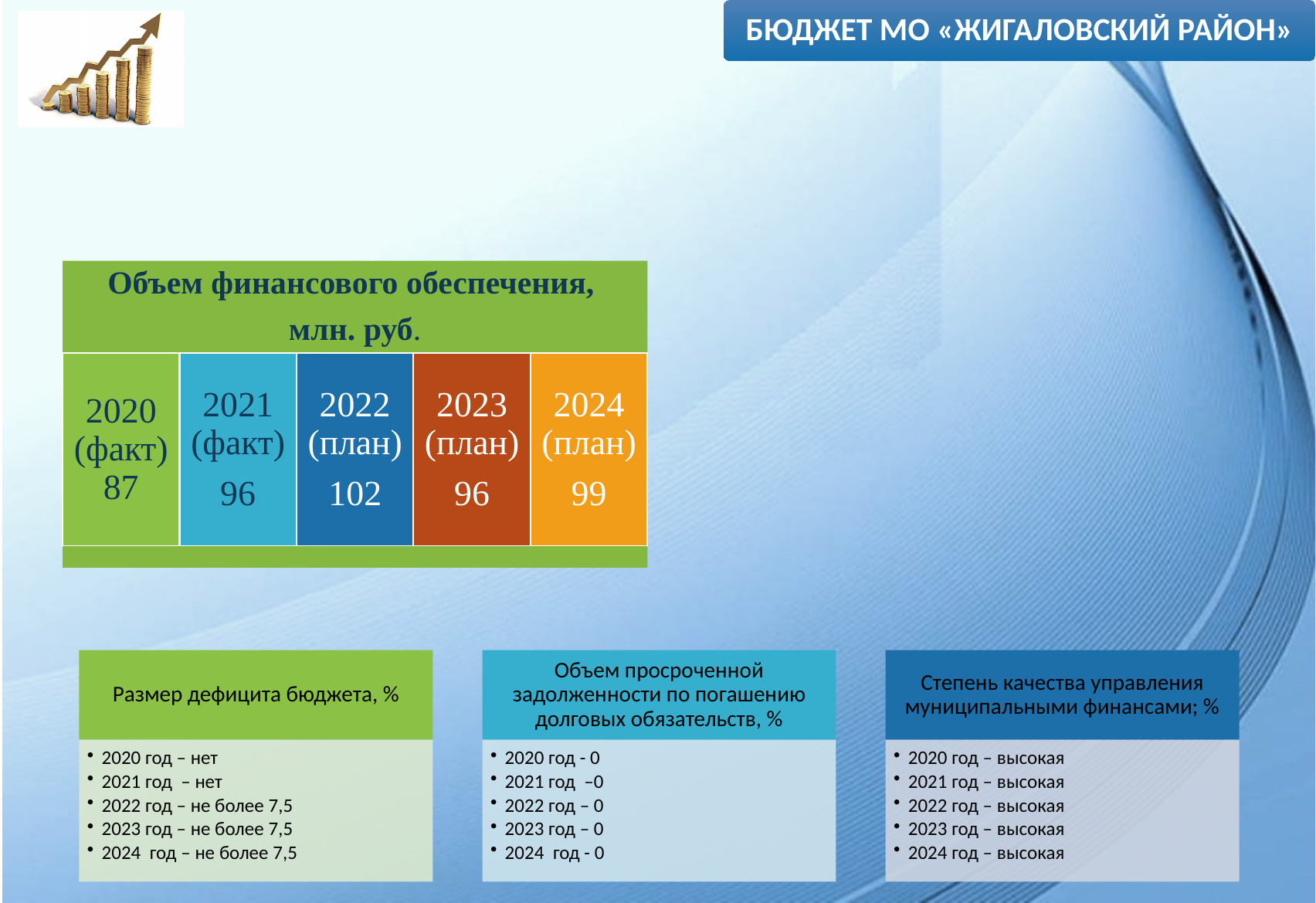
In the 'Объем финансового обеспечения, млн. руб.' graphic, what is the difference between the 2024 (план) value and the 2023 (план) value? 3 In the 'Объем финансового обеспечения, млн. руб.' graphic, what is the value for 2022 (план)? 102 In the 'Объем финансового обеспечения, млн. руб.' graphic, what is the value for 2020 (факт)? 87 In the 'Объем финансового обеспечения, млн. руб.' graphic, which is larger: the value for 2021 (факт) or the value for 2024 (план)? 2024 (план) What unit is given in the title of the 'Объем финансового обеспечения' graphic? млн. руб. In the 'Объем финансового обеспечения, млн. руб.' graphic, how many years are shown? 5 In the 'Объем финансового обеспечения, млн. руб.' graphic, does the value rise or fall from 2020 (факт) to 2022 (план)? rise In the 'Объем финансового обеспечения, млн. руб.' graphic, what is the value for 2024 (план)? 99 In the 'Объем финансового обеспечения, млн. руб.' graphic, how many years are marked as 'план'? 3 In the 'Объем финансового обеспечения, млн. руб.' graphic, which year has the lowest value? 2020 (факт) In the 'Объем финансового обеспечения, млн. руб.' graphic, what is the difference between the 2022 (план) value and the 2020 (факт) value? 15 In the 'Объем финансового обеспечения, млн. руб.' graphic, which year has the highest value? 2022 (план)